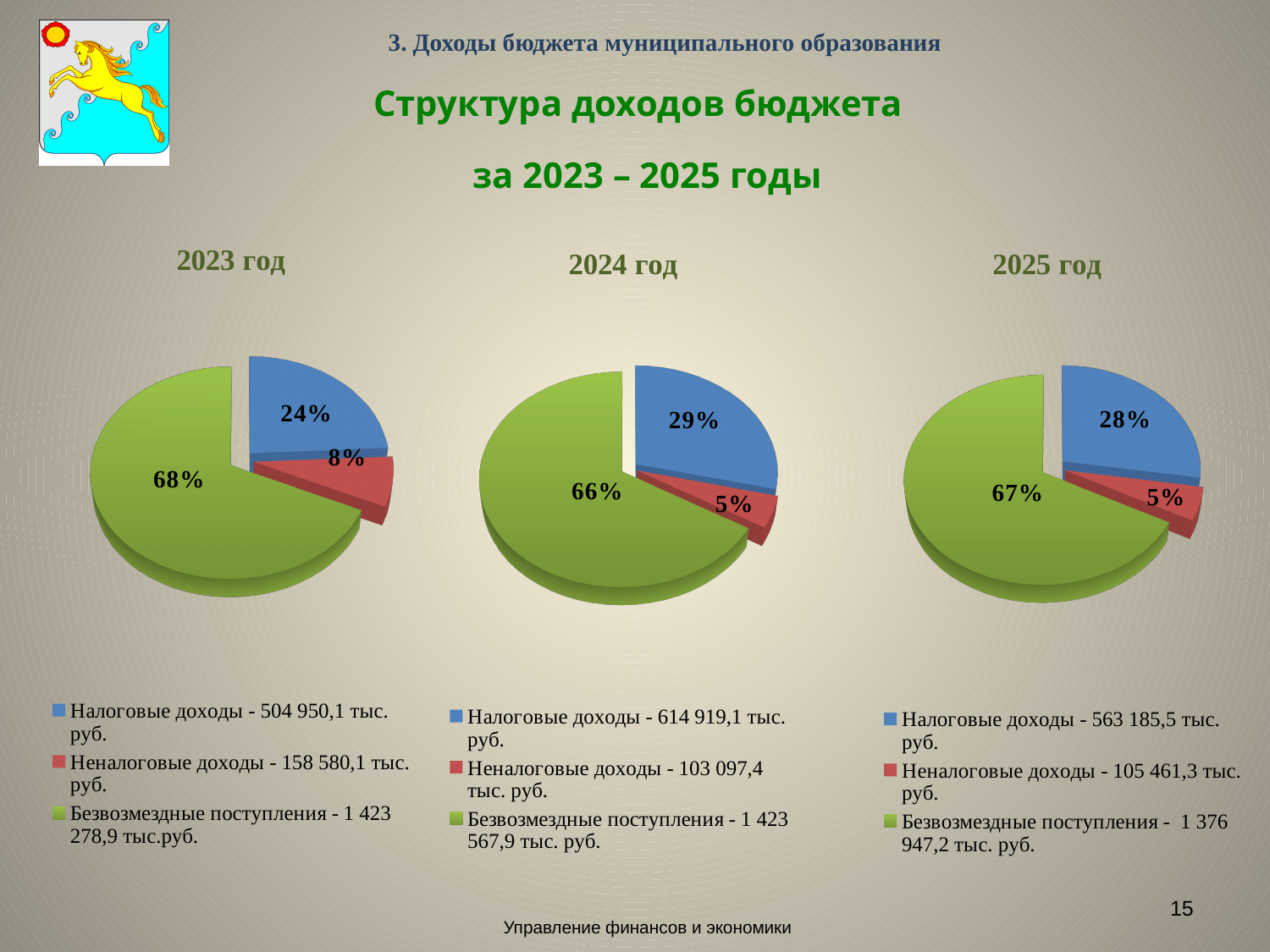
According to the legend of the 2025 год chart, what is the value of Безвозмездные поступления? 1 376 947,2 тыс. руб. Which is larger: the Налоговые доходы share in the 2024 год chart or in the 2025 год chart? 2024 год In the 2024 год pie chart, what share is labelled for Безвозмездные поступления (green slice)? 66% How many slices does the 2025 год pie chart have? 3 In the 2023 год pie chart, what is the difference in percentage points between the Безвозмездные поступления slice and the Налоговые доходы slice? 44 In the 2024 год pie chart, which category has the largest slice? Безвозмездные поступления According to the legend of the 2024 год chart, what is the value of Налоговые доходы? 614 919,1 тыс. руб. What type of chart is used for the 2023 год data? Pie chart In the 2023 год pie chart, what share is labelled for Неналоговые доходы (red slice)? 8% In the 2023 год pie chart, what share is labelled for Налоговые доходы (blue slice)? 24% In the 2025 год pie chart, which category has the smallest slice? Неналоговые доходы